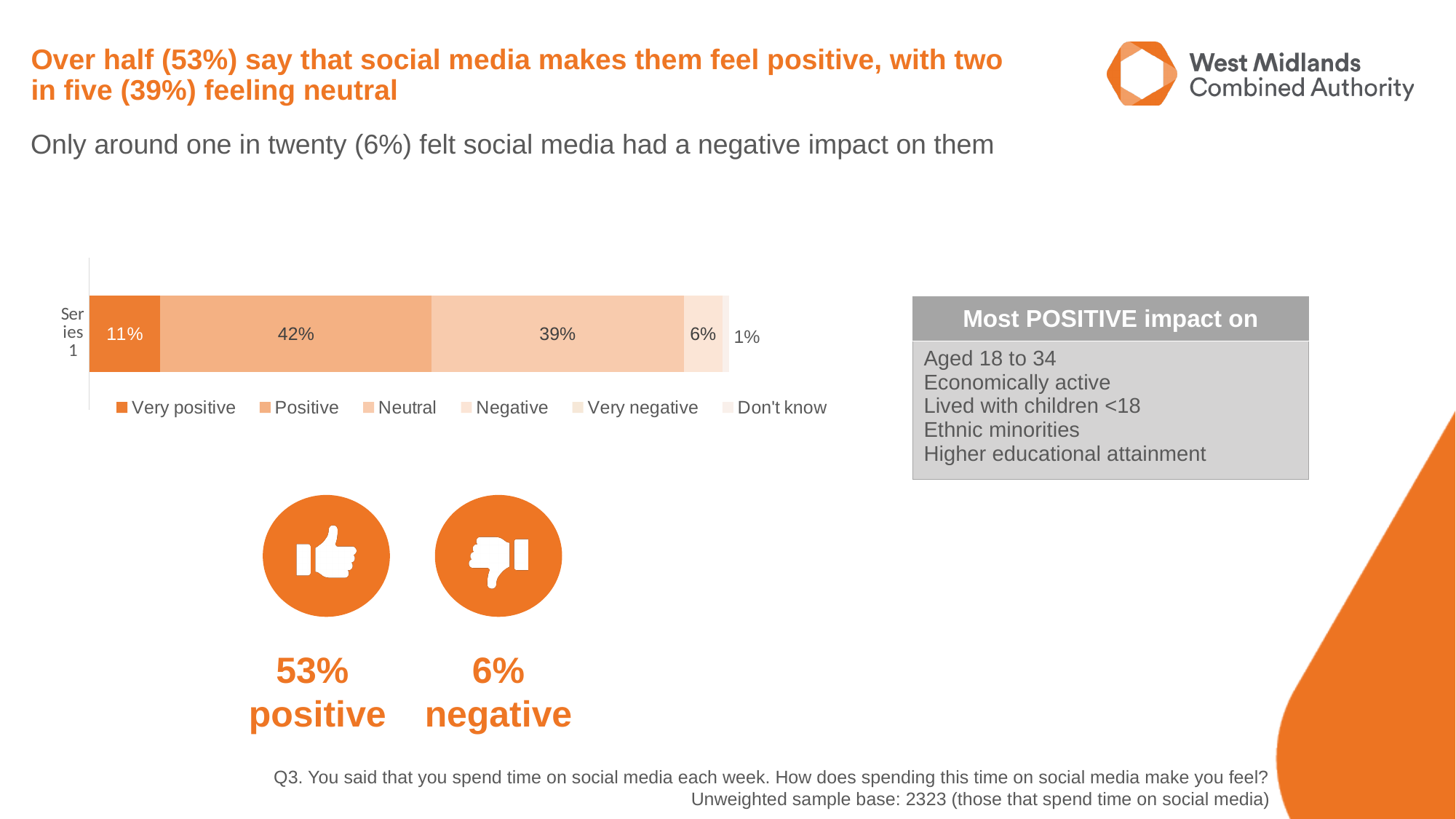
What type of chart is shown on the slide? Stacked bar chart How much larger is the Positive segment than the Very positive segment? 31% Which is larger, the Positive segment or the Neutral segment? Positive What is the value shown for the Negative segment? 6% How many entries does the chart legend list? 6 What is the value of the Positive segment in the stacked bar? 42% What is the first entry in the chart legend? Very positive Which response category has the largest segment in the stacked bar? Positive What is the difference between the Neutral and Negative segments? 33% What percentage of respondents felt neutral about social media? 39% What percentage of respondents said social media makes them feel very positive? 11% What is the difference between the Positive (42%) and Neutral (39%) segments? 3%